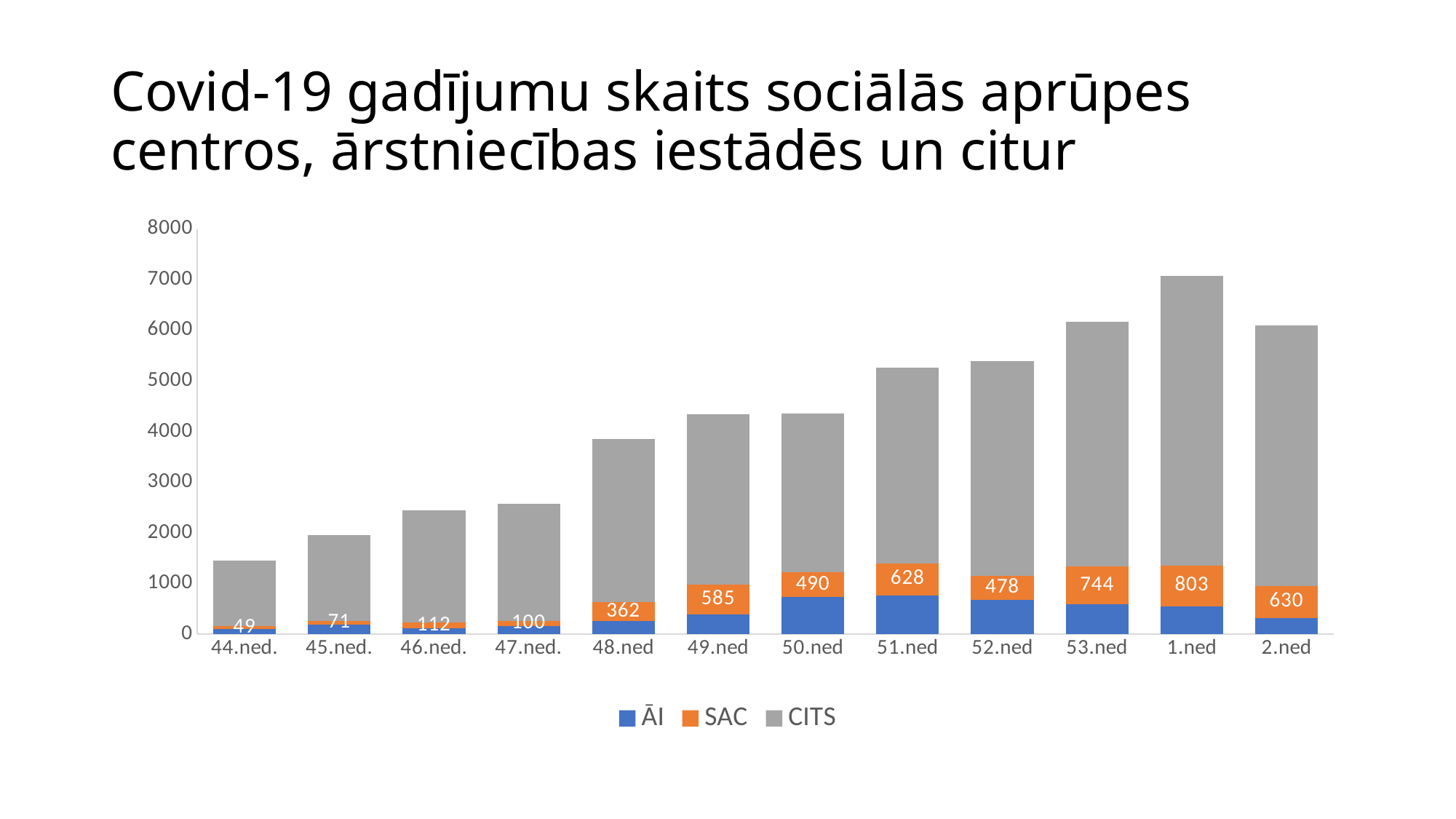
What is the difference between the SAC values for 53.ned and 52.ned? 266 Which week has the lowest SAC value? 44.ned. Is the total value of the bar for 53.ned greater or less than 6000? greater Which has a larger SAC value, 51.ned or 2.ned? 2.ned What kind of chart is shown on the slide? Stacked bar chart Do the total bar heights generally rise or fall from 44.ned. to 1.ned? Rise How many series does the legend list? 3 How many weeks are shown on the x axis? 12 What is the SAC value for 48.ned? 362 Which week has the highest SAC value? 1.ned Is the total value of the bar for 44.ned. greater or less than 2000? less What is the SAC value for 1.ned? 803